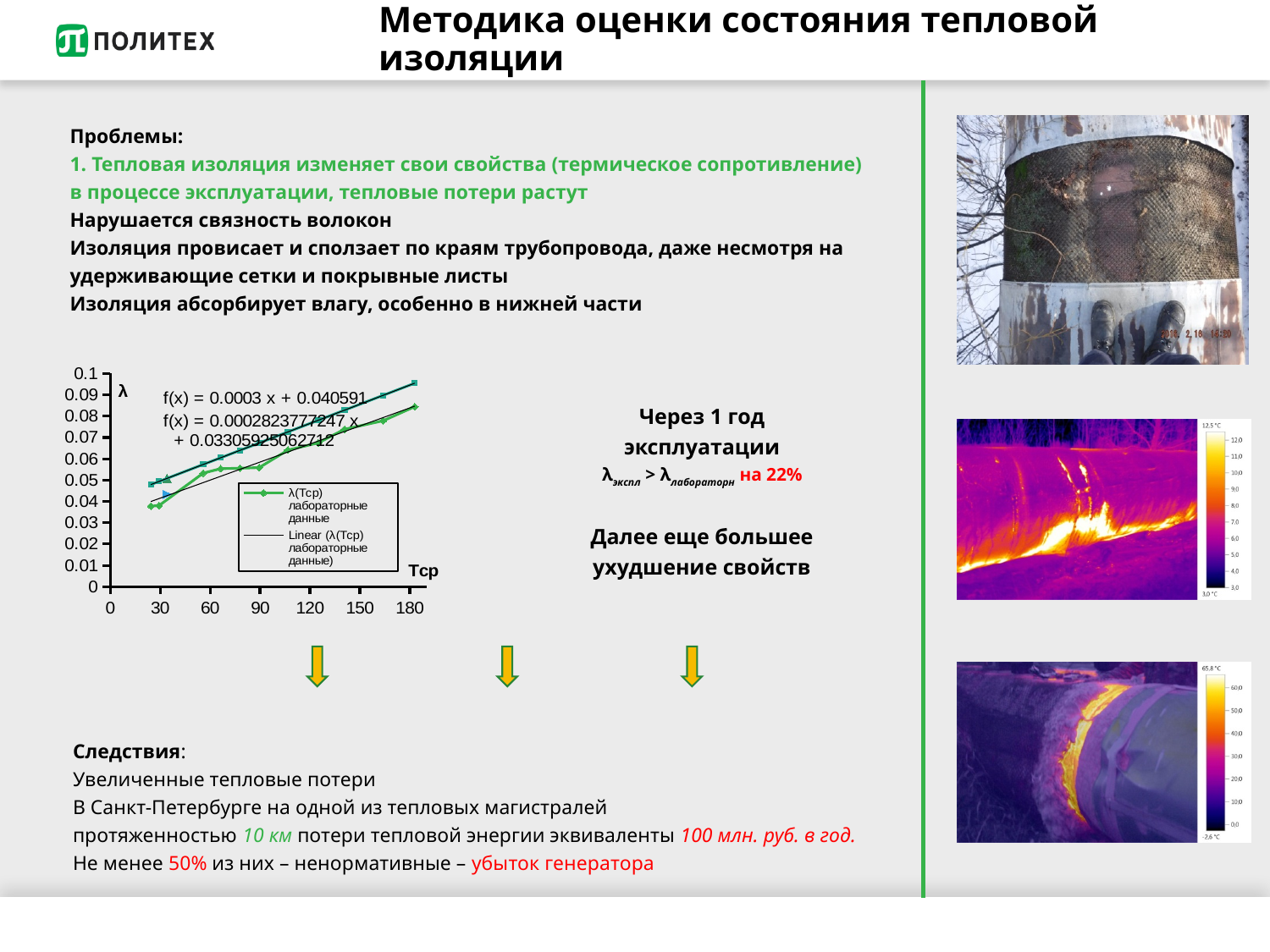
Do the plotted λ values rise or fall as Tcp increases? rise Is the value of the upper series at Tcp = 180 greater or less than 0.09? greater What is the second trendline equation printed on the chart? f(x) = 0.0002823777247 x + 0.03305925062712 What is the highest value shown on the y axis of the chart? 0.1 What is the first trendline equation printed on the chart? f(x) = 0.0003 x + 0.040591 How many tick labels are shown on the x axis of the chart? 7 Is the value of the lower (green) series at Tcp = 180 greater or less than 0.09? less What is the label on the y axis of the chart? λ Is the value of the lower (green) series at Tcp = 30 greater or less than 0.05? less What is the label on the x axis of the chart? Tcp What kind of chart is shown on the slide? line chart